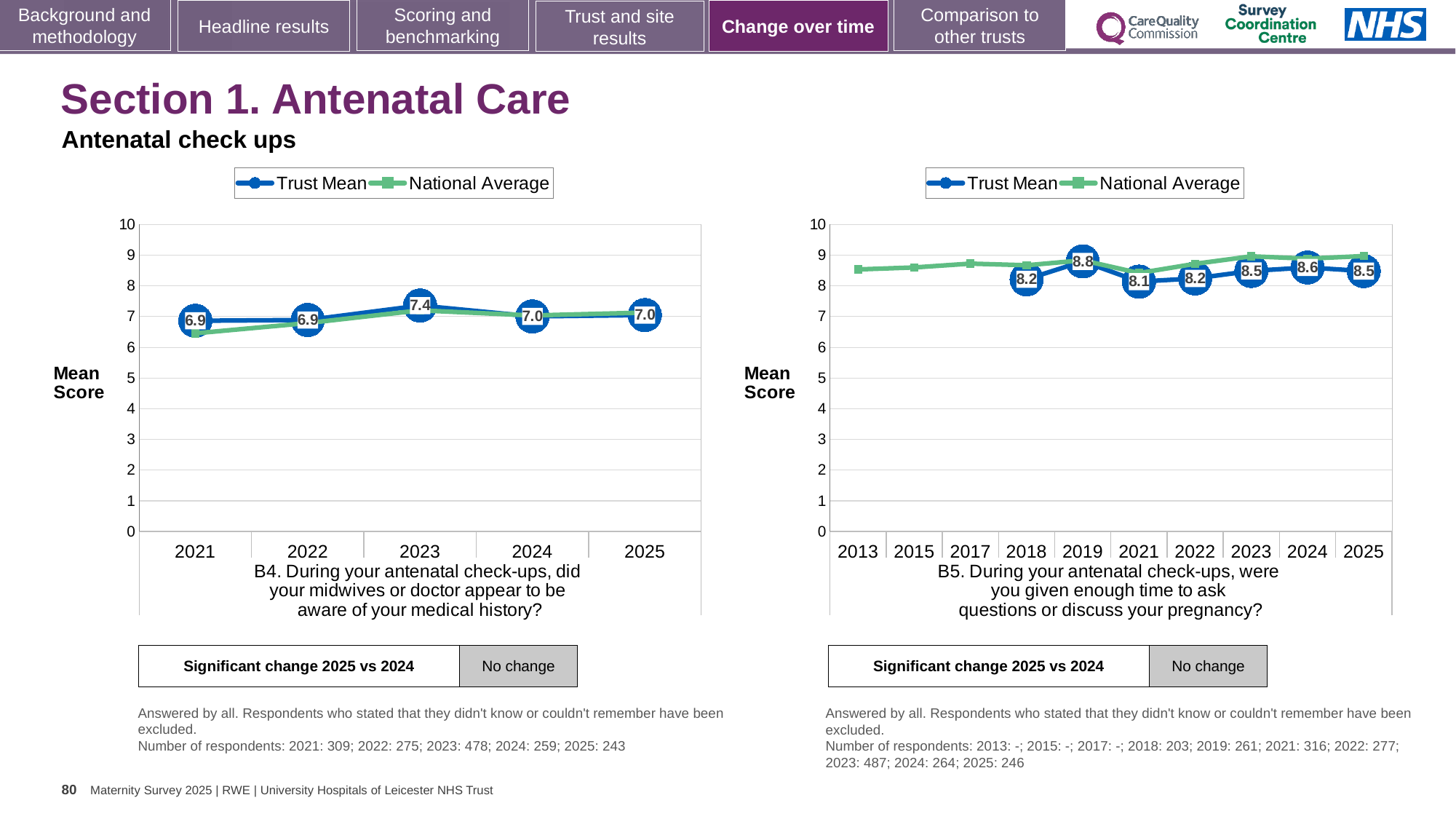
In the B4 chart (left), which year has the highest Trust Mean? 2023 In the B5 chart (right), what is the Trust Mean for 2019? 8.8 In the B4 chart (left), what is the difference between the Trust Mean for 2023 and 2024? 0.4 In the B5 chart (right), is the National Average for 2013 greater or less than 8? greater In the B5 chart (right), is the Trust Mean for 2024 larger or smaller than the Trust Mean for 2022? larger In the B4 chart (left), how many years are shown on the x axis? 5 What kind of chart is the B4 chart (left)? Line chart In the B5 chart (right), which year has the lowest labelled Trust Mean? 2021 In the B4 chart (left), what is the Trust Mean for 2021? 6.9 In the B5 chart (right), how many series does the legend list? 2 In the B4 chart (left), what is the Trust Mean for 2023? 7.4 In the B5 chart (right), what is the Trust Mean for 2025? 8.5